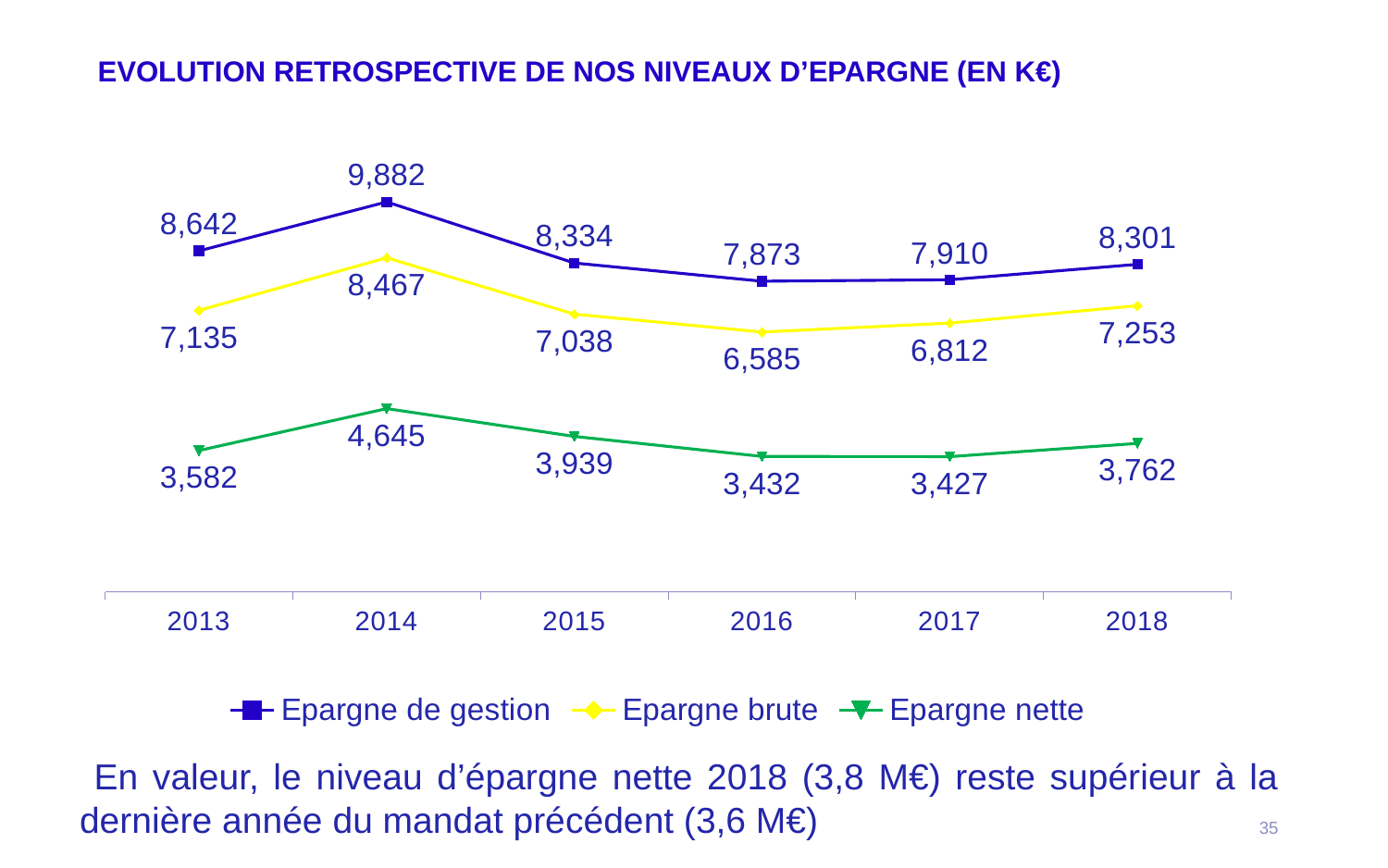
What type of chart is shown on the slide? line chart How many years are shown on the x axis? 6 In which year is Epargne de gestion highest? 2014 Which is larger: Epargne brute in 2013 or Epargne brute in 2018? Epargne brute in 2018 What is the value of Epargne nette in 2018? 3,762 What is the difference between Epargne nette in 2018 and in 2013? 180 What is the difference between Epargne de gestion in 2014 and in 2013? 1,240 Does Epargne de gestion rise or fall from 2014 to 2016? fall What is the value of Epargne brute in 2016? 6,585 How many series does the legend list? 3 In which year is Epargne nette lowest? 2017 What is the value of Epargne de gestion in 2014? 9,882